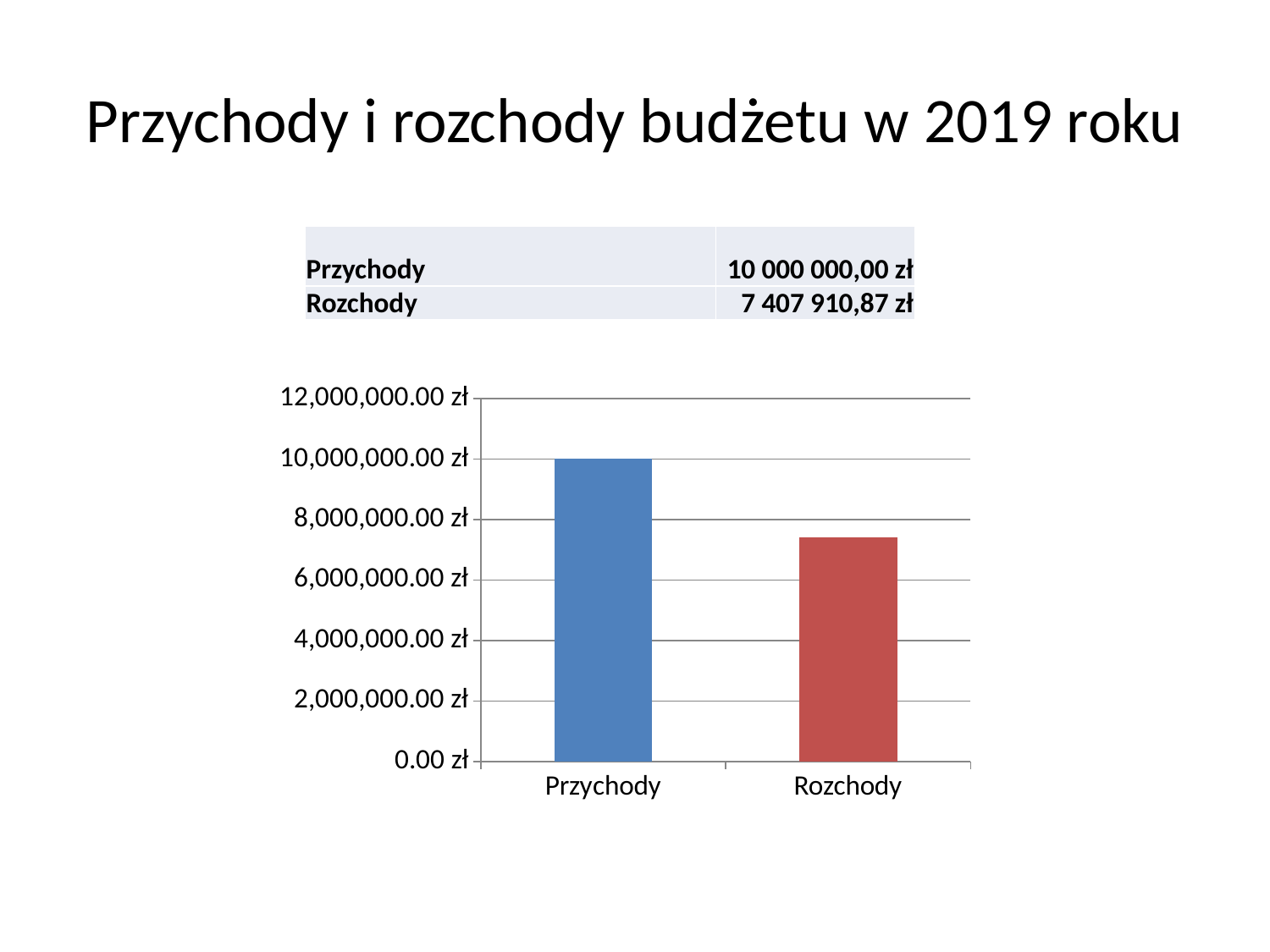
What is the value for Rozchody as shown in the table on the slide? 7 407 910,87 zł Which category has the lowest value in the chart? Rozchody What is the highest value shown on the vertical axis of the chart? 12,000,000.00 zł Which category has the highest value in the chart? Przychody Is the value for Przychody greater or less than 8,000,000.00 zł? greater Is the value for Rozchody greater or less than 8,000,000.00 zł? less How many categories are plotted in the chart? 2 What is the value for Przychody as shown in the table on the slide? 10 000 000,00 zł Which category has the higher value, Przychody or Rozchody? Przychody What is the difference between the Przychody and Rozchody values shown in the table? 2 592 089,13 zł What type of chart is shown on the slide? bar chart What colour is the bar for Rozchody? red